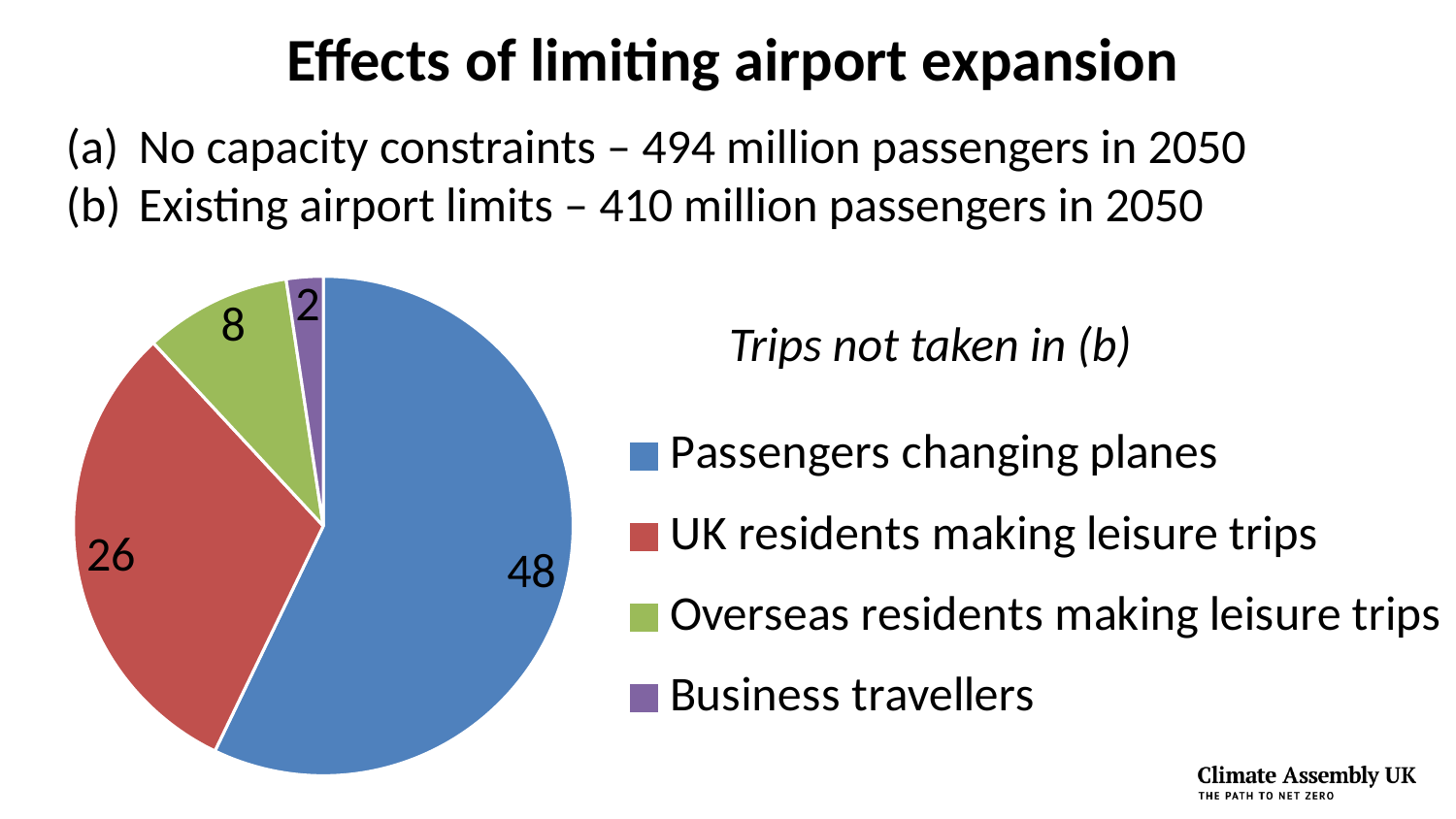
What is the title of the pie chart? Trips not taken in (b) Which category has the smallest slice of the pie chart? Business travellers What value is shown for Passengers changing planes in the pie chart? 48 What is the total of all the values shown in the pie chart? 84 What kind of chart is shown on the slide? Pie chart What is the difference between the values for Passengers changing planes and UK residents making leisure trips? 22 Which is larger: the value for Overseas residents making leisure trips or the value for Business travellers? Overseas residents making leisure trips Which category has the largest slice of the pie chart? Passengers changing planes What value is shown for Business travellers in the pie chart? 2 How many categories does the pie chart show? 4 What value is shown for Overseas residents making leisure trips in the pie chart? 8 What value is shown for UK residents making leisure trips in the pie chart? 26